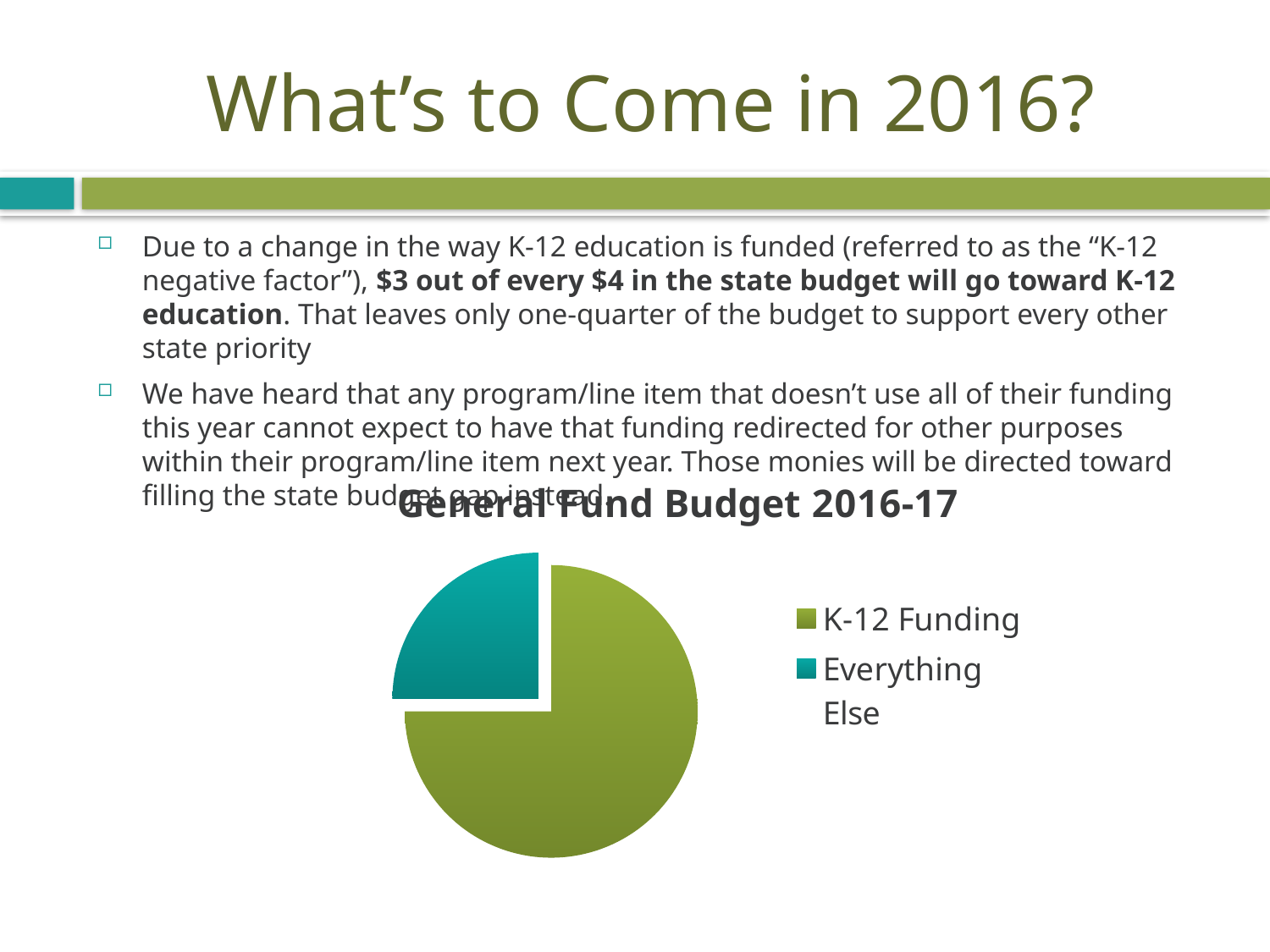
What is the title of the chart? General Fund Budget 2016-17 What kind of chart is shown on the slide? pie chart Which is larger in the pie chart, K-12 Funding or Everything Else? K-12 Funding How many entries does the chart's legend list? 2 What colour is the K-12 Funding slice in the pie chart? green Which slice of the pie chart is the smallest? Everything Else How many slices does the pie chart have? 2 Which legend entry is shown in teal in the pie chart? Everything Else Which slice of the pie chart is the largest? K-12 Funding